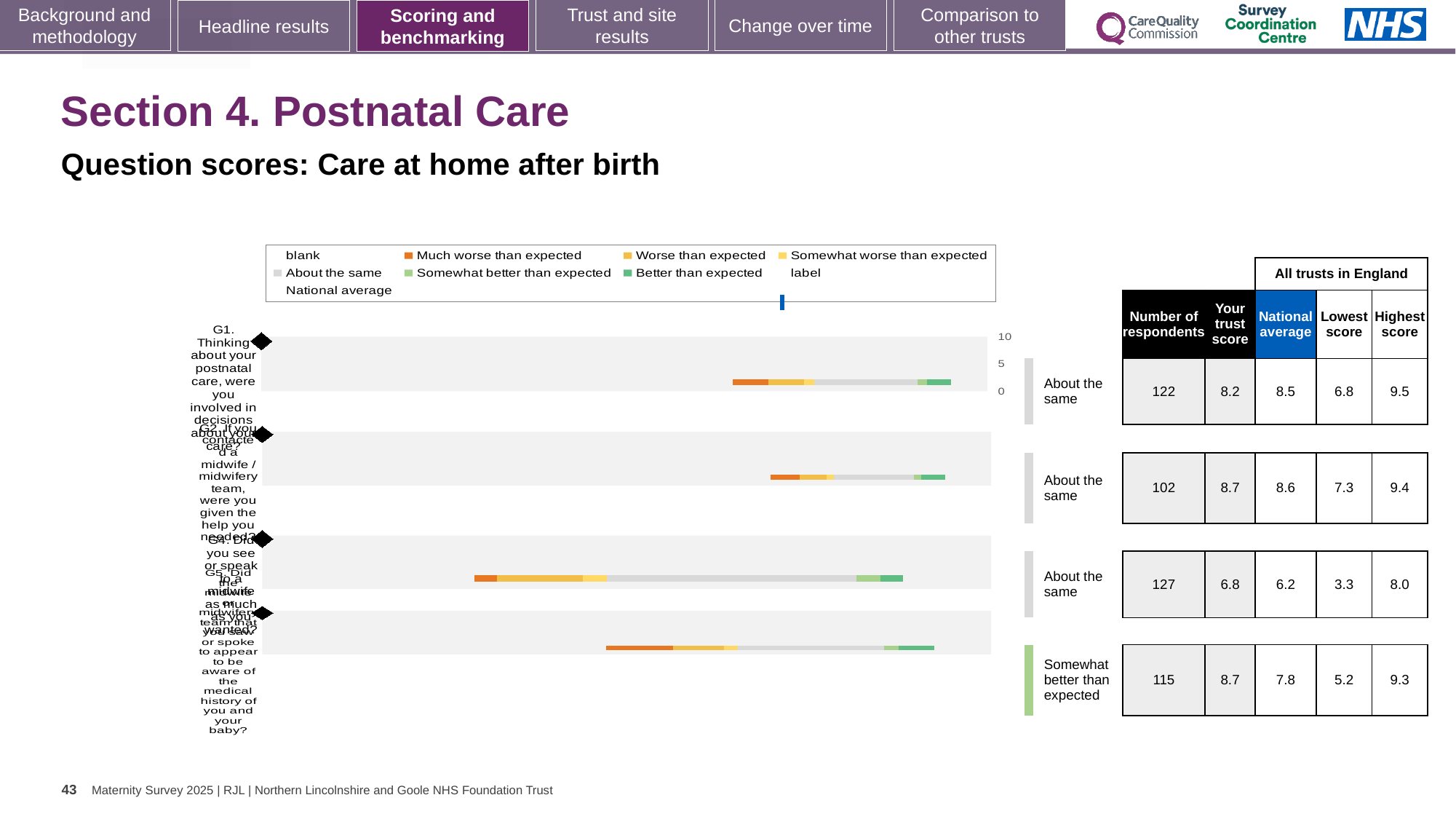
How many question bars are plotted in the chart? 4 For the first question (G1), which is larger: the trust score or the national average? national average What is the trust score for the first question (G1)? 8.2 What is the national average for the fourth (bottom) question? 7.8 What is the difference between the highest score and the lowest score for the third question row? 4.7 What is the number of respondents for the first question (G1)? 122 Which question row has the highest number of respondents? the third row (127) What is the subtitle of the slide describing the chart? Question scores: Care at home after birth Which colour in the legend represents 'Much worse than expected'? orange What kind of chart is shown on the slide? bar chart How many entries does the chart legend list? 9 What benchmark category is shown for the fourth (bottom) question row? Somewhat better than expected